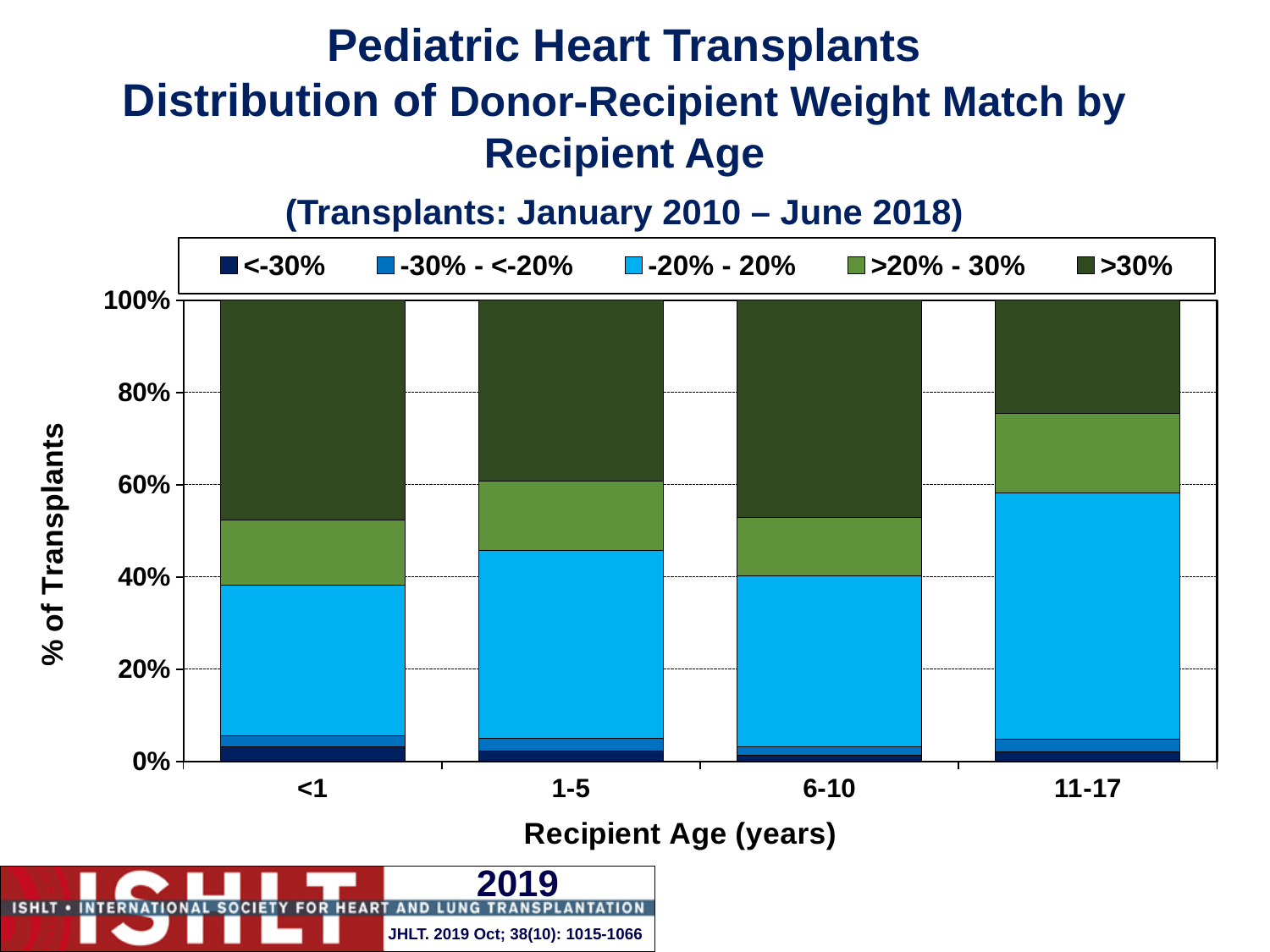
Which recipient age group has the smallest >30% segment? 11-17 Which recipient age group has the largest -20% - 20% segment? 11-17 How many recipient age groups are shown on the x axis? 4 How many series does the legend list? 5 Is the -20% - 20% segment larger for the 11-17 age group or the <1 age group? 11-17 What is the label of the x axis? Recipient Age (years) What kind of chart is shown on the slide? stacked bar chart Is the >30% segment for the <1 age group greater or less than 40%? greater What is the label of the y axis? % of Transplants Is the >30% segment larger for the <1 age group or the 11-17 age group? <1 What is the total height of the stacked bar for the 6-10 age group? 100% Is the >30% segment for the 11-17 age group greater or less than 40%? less